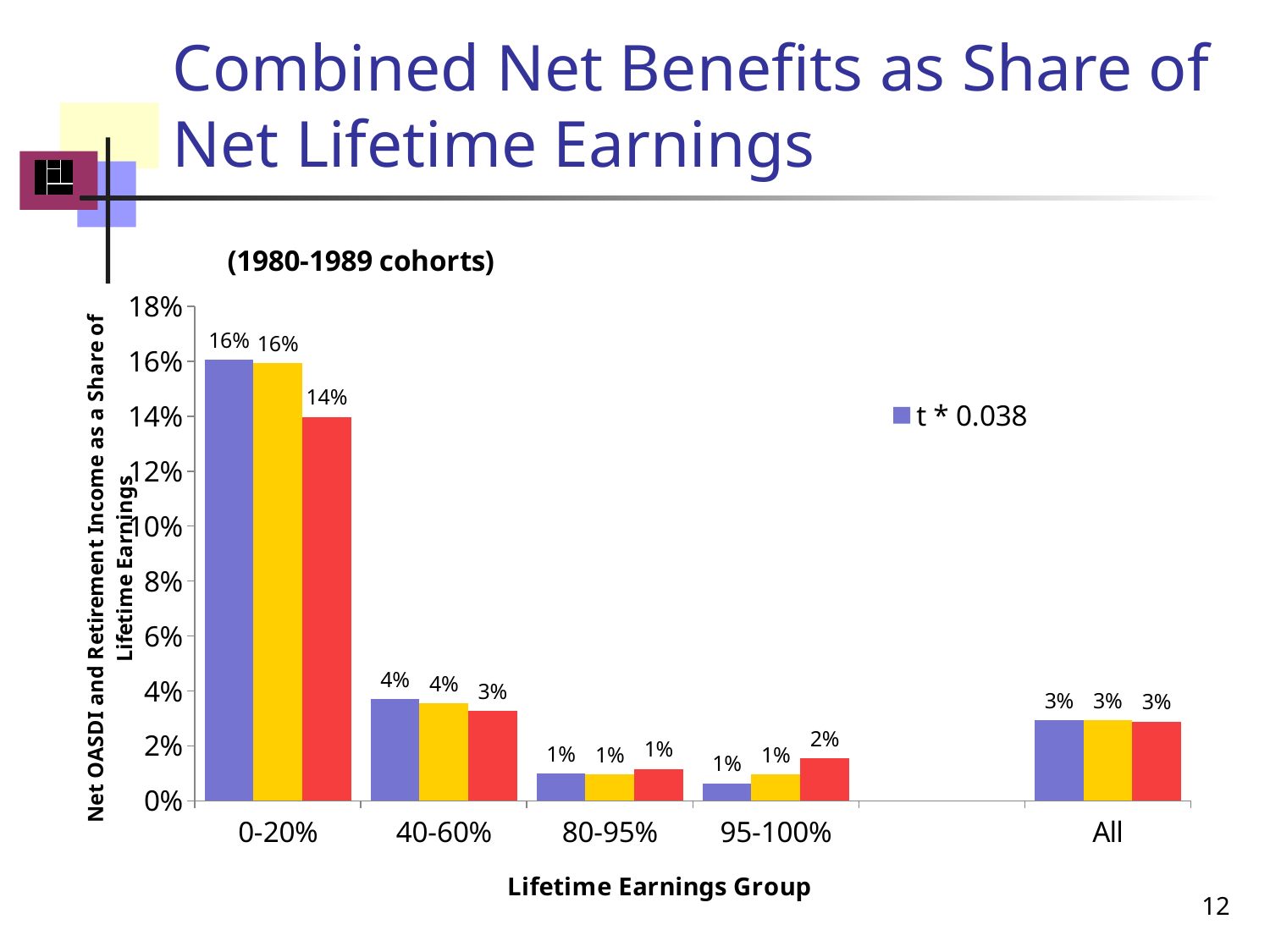
What is the value of the blue bar for the 0-20% group? 16% Do the blue bars rise or fall from the 0-20% group to the 95-100% group? fall What kind of chart is shown on the slide? bar chart Which lifetime earnings group has the lowest red bar? 80-95% How many series does the legend list? 1 Which is larger: the blue bar for 40-60% or the blue bar for All? 40-60% How many lifetime earnings groups are shown on the x axis? 5 What is the value of the red bar for the 0-20% group? 14% Is the value of the yellow bar for the 0-20% group greater or less than 14%? greater What is the difference between the blue bar and the red bar for the 0-20% group? 2% Which lifetime earnings group has the highest blue bar? 0-20% What is the value of the yellow bar for the All group? 3%